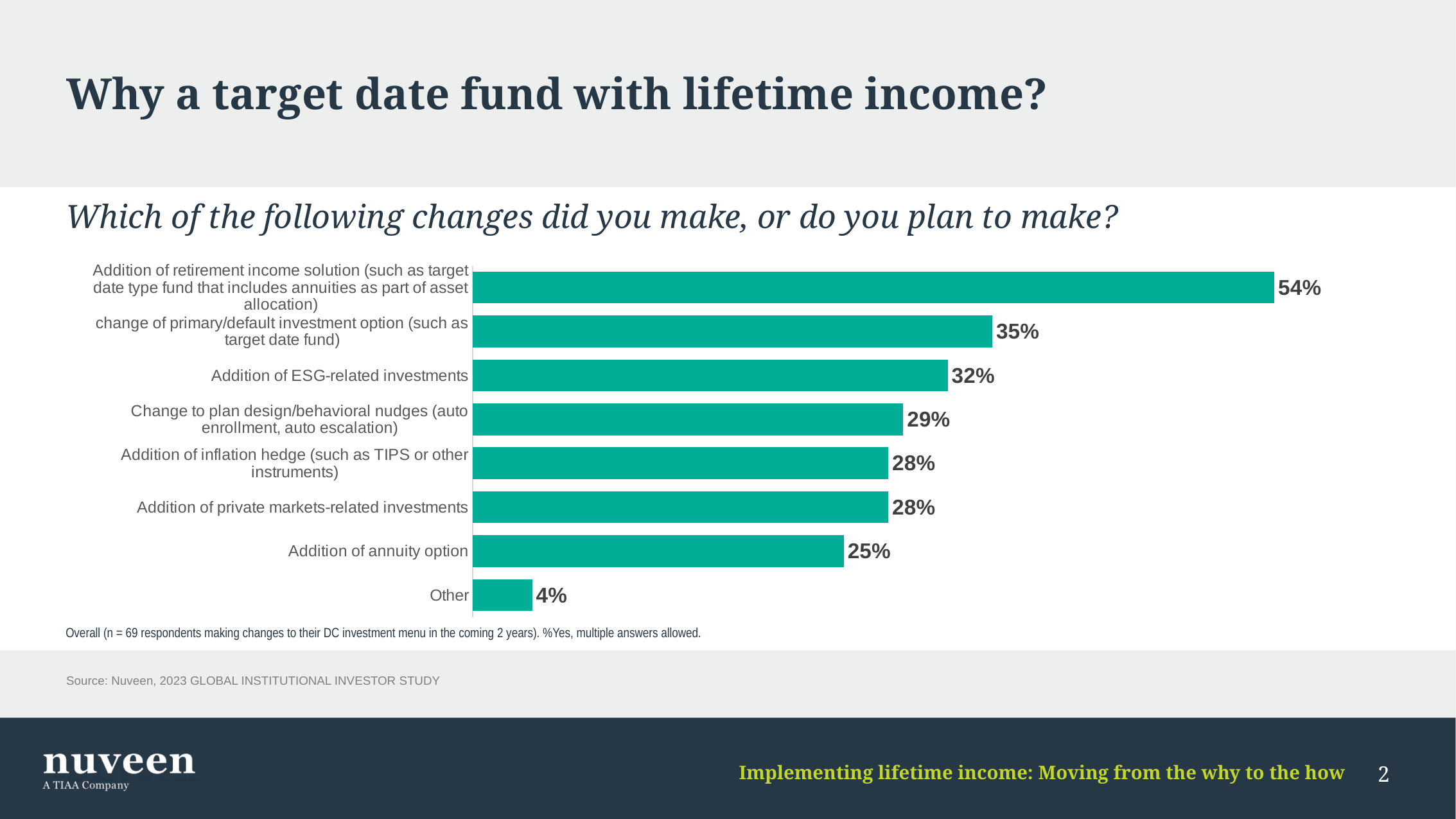
What is the value for "Change to plan design/behavioral nudges (auto enrollment, auto escalation)"? 29% What question does the chart answer, as stated in the subtitle above it? Which of the following changes did you make, or do you plan to make? What kind of chart is shown on the slide? Bar chart What percentage of respondents selected "Addition of ESG-related investments"? 32% Which is larger: the value for "Addition of ESG-related investments" or the value for "Addition of annuity option"? Addition of ESG-related investments What is the difference between the value for "Addition of inflation hedge (such as TIPS or other instruments)" and the value for "Other"? 24% What is the value for "Other"? 4% How many categories are shown in the chart? 8 Which category has the lowest value? Other Which category has the highest value? Addition of retirement income solution (such as target date type fund that includes annuities as part of asset allocation) What is the value for "Addition of annuity option"? 25% What is the difference between the value for "Addition of retirement income solution" and the value for "change of primary/default investment option"? 19%